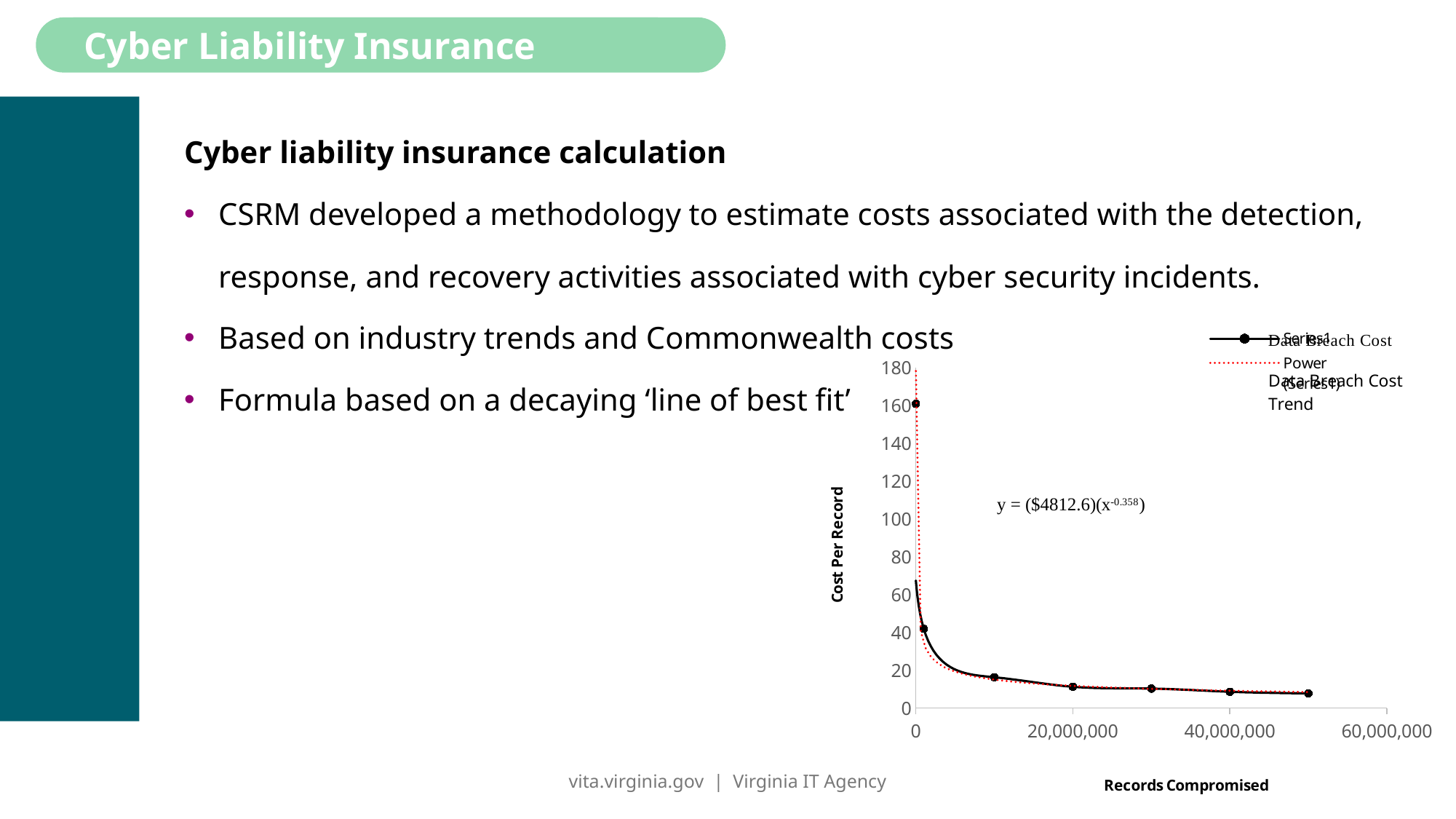
How do the cost-per-record values change as the number of records compromised increases along the x axis? They fall Which data point has the highest cost per record? The point nearest 0 records compromised What kind of chart is shown on the slide? Line chart with a trendline How many series does the chart legend list? 2 Is the cost per record at 20,000,000 records compromised greater or less than 20? less What is the trendline equation printed on the chart? y = ($4812.6)(x^-0.358) Which has a higher cost per record: the data point near 1,000,000 records compromised or the one at 20,000,000 records compromised? The point near 1,000,000 records compromised Is the cost per record for the first data point (near 0 records compromised) greater or less than 140? greater Is the cost per record at 40,000,000 records compromised greater or less than 20? less How many data points are plotted on the Data Breach Cost series? 7 What is the title of the horizontal axis of the chart? Records Compromised What is the title of the vertical axis of the chart? Cost Per Record